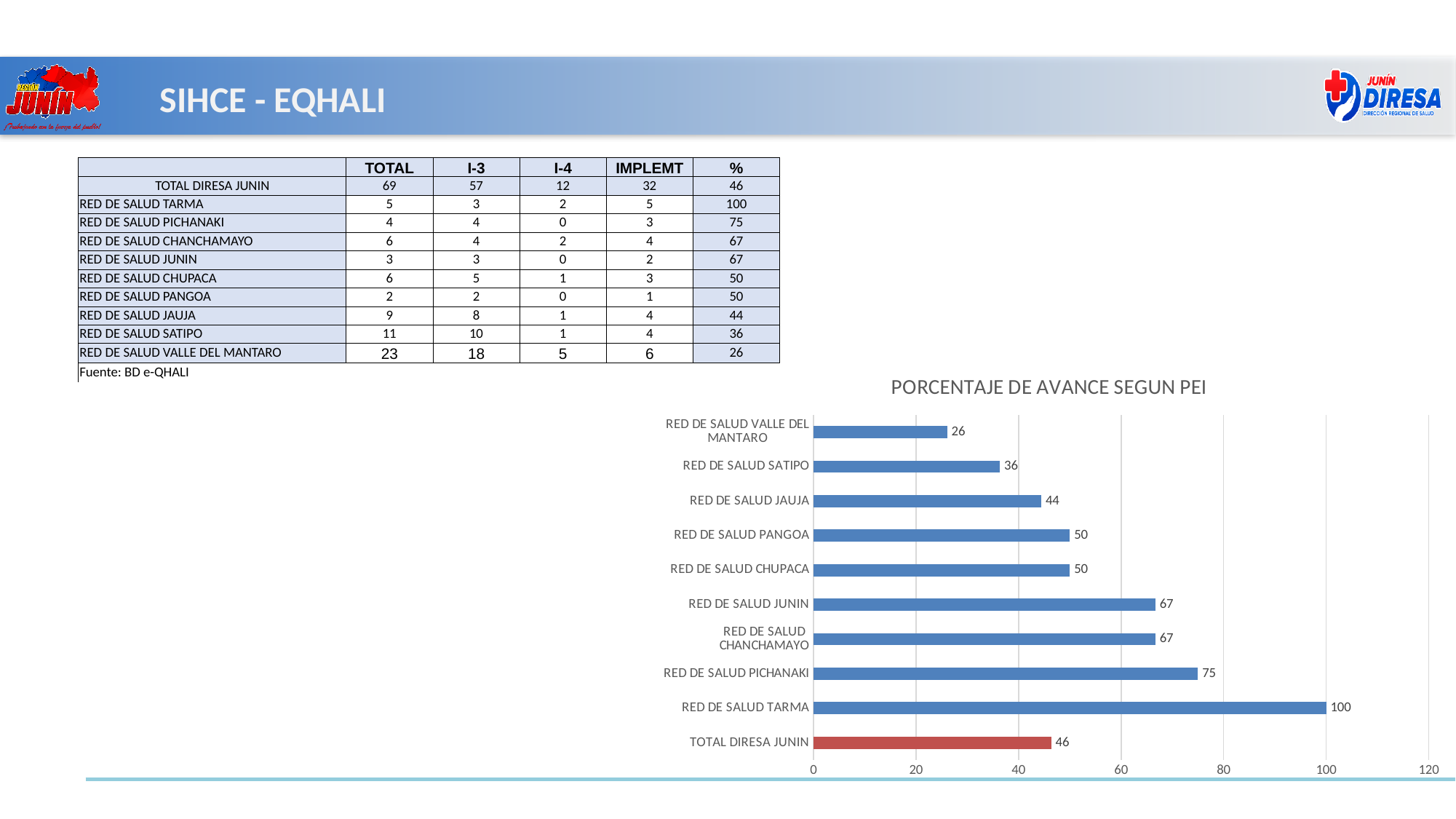
What is the value for TOTAL DIRESA JUNIN in the chart? 46 Which is larger, the value for RED DE SALUD JAUJA or the value for RED DE SALUD SATIPO? RED DE SALUD JAUJA Which category has the highest value in the chart? RED DE SALUD TARMA What is the title of the chart? PORCENTAJE DE AVANCE SEGUN PEI Which category has the lowest value in the chart? RED DE SALUD VALLE DEL MANTARO Is the value for RED DE SALUD PICHANAKI greater or less than 60? greater Which bar in the chart is coloured differently from the others? TOTAL DIRESA JUNIN What is the difference between the values for RED DE SALUD TARMA and RED DE SALUD PICHANAKI? 25 What is the value for RED DE SALUD TARMA in the chart? 100 What kind of chart is shown on the slide? bar chart What is the value for RED DE SALUD VALLE DEL MANTARO in the chart? 26 How many categories are plotted in the chart? 10